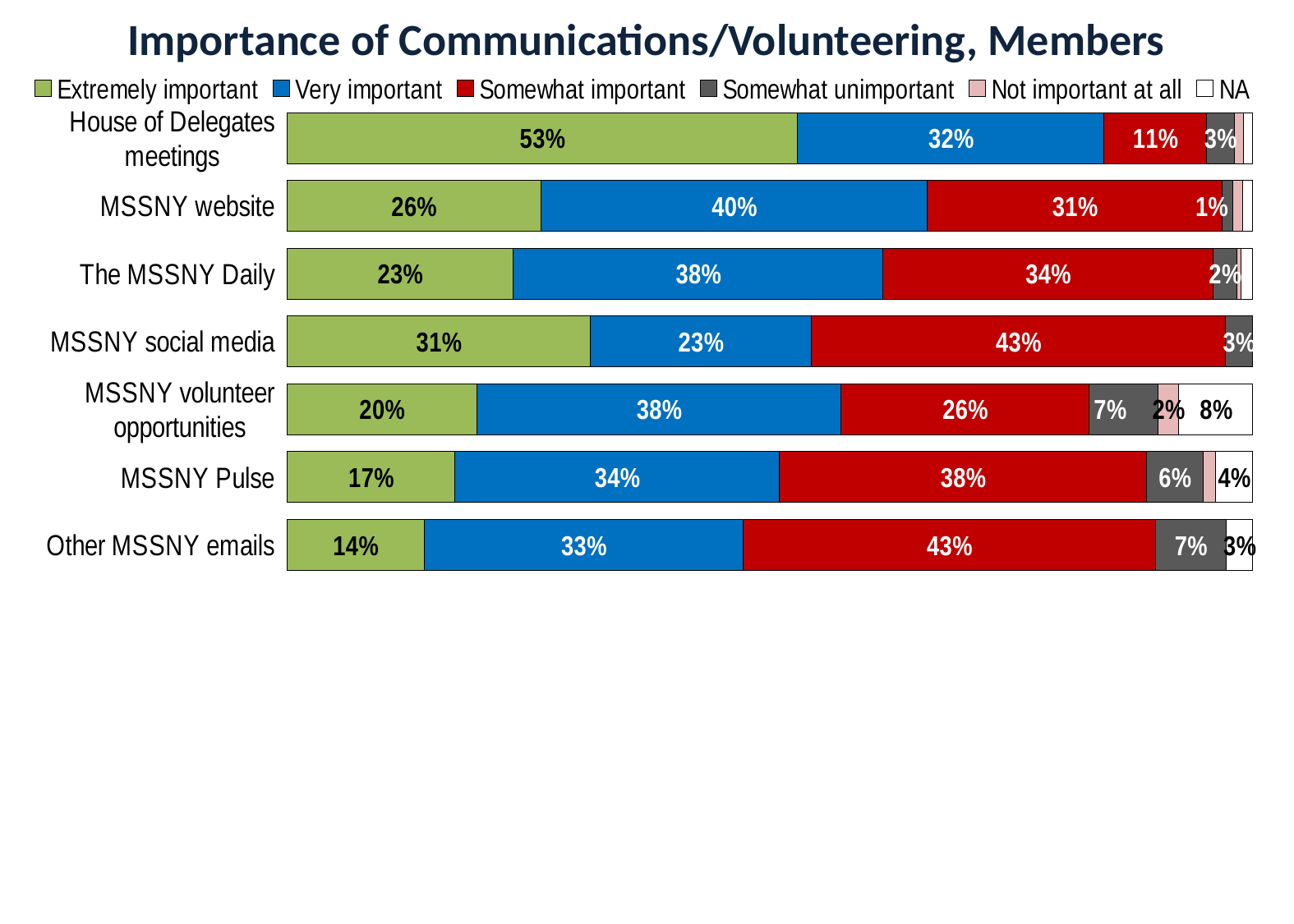
What kind of chart is shown on the slide? Stacked bar chart What percentage of members rated House of Delegates meetings as Extremely important? 53% How many series does the legend list? 6 What is the NA value for MSSNY volunteer opportunities? 8% Which has a larger Very important value, The MSSNY Daily or MSSNY Pulse? The MSSNY Daily What is the Very important value for MSSNY website? 40% What is the Somewhat important value for Other MSSNY emails? 43% How many categories (communication/volunteering items) are plotted? 7 For MSSNY social media, how much larger is the Somewhat important value than the Very important value? 20 percentage points Which category has the highest Extremely important percentage? House of Delegates meetings What colour represents the Somewhat important series? Red Which category has the lowest Extremely important percentage? Other MSSNY emails